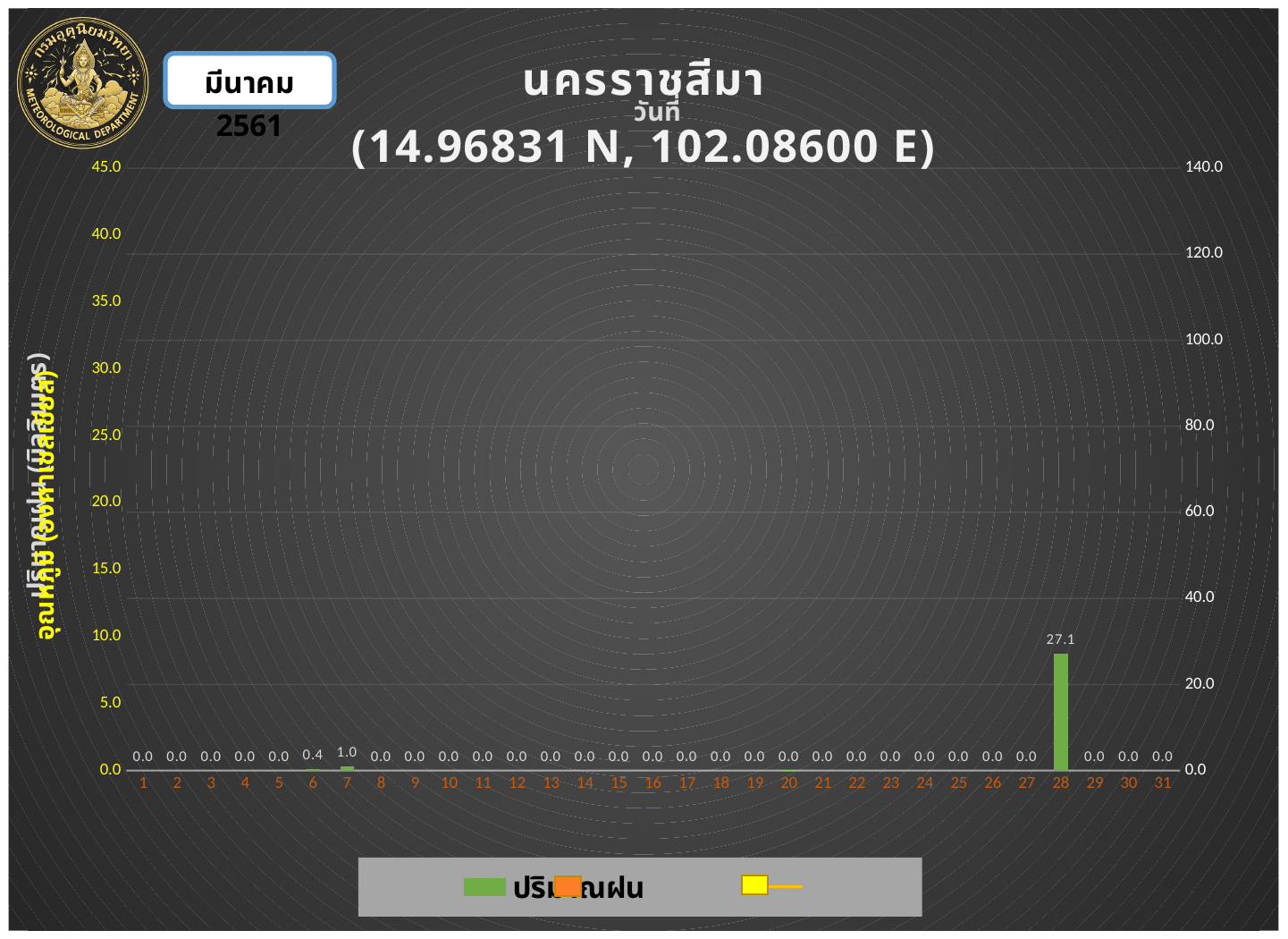
What is the rainfall value shown for day 15? 0.0 What is the difference between the rainfall values for day 28 and day 6? 26.7 How many days are shown along the x axis? 31 Which has the larger rainfall value, day 6 or day 7? day 7 What is the rainfall value shown for day 7? 1.0 What is the difference between the rainfall values for day 28 and day 7? 26.1 What kind of chart is shown on the slide? bar chart What coordinates are given in the chart title? 14.96831 N, 102.08600 E What is the rainfall value shown for day 6? 0.4 What is the rainfall value shown for day 28? 27.1 Is the bar for day 28 greater or less than 20.0 on the right-hand axis? greater Which day has the highest rainfall value? 28